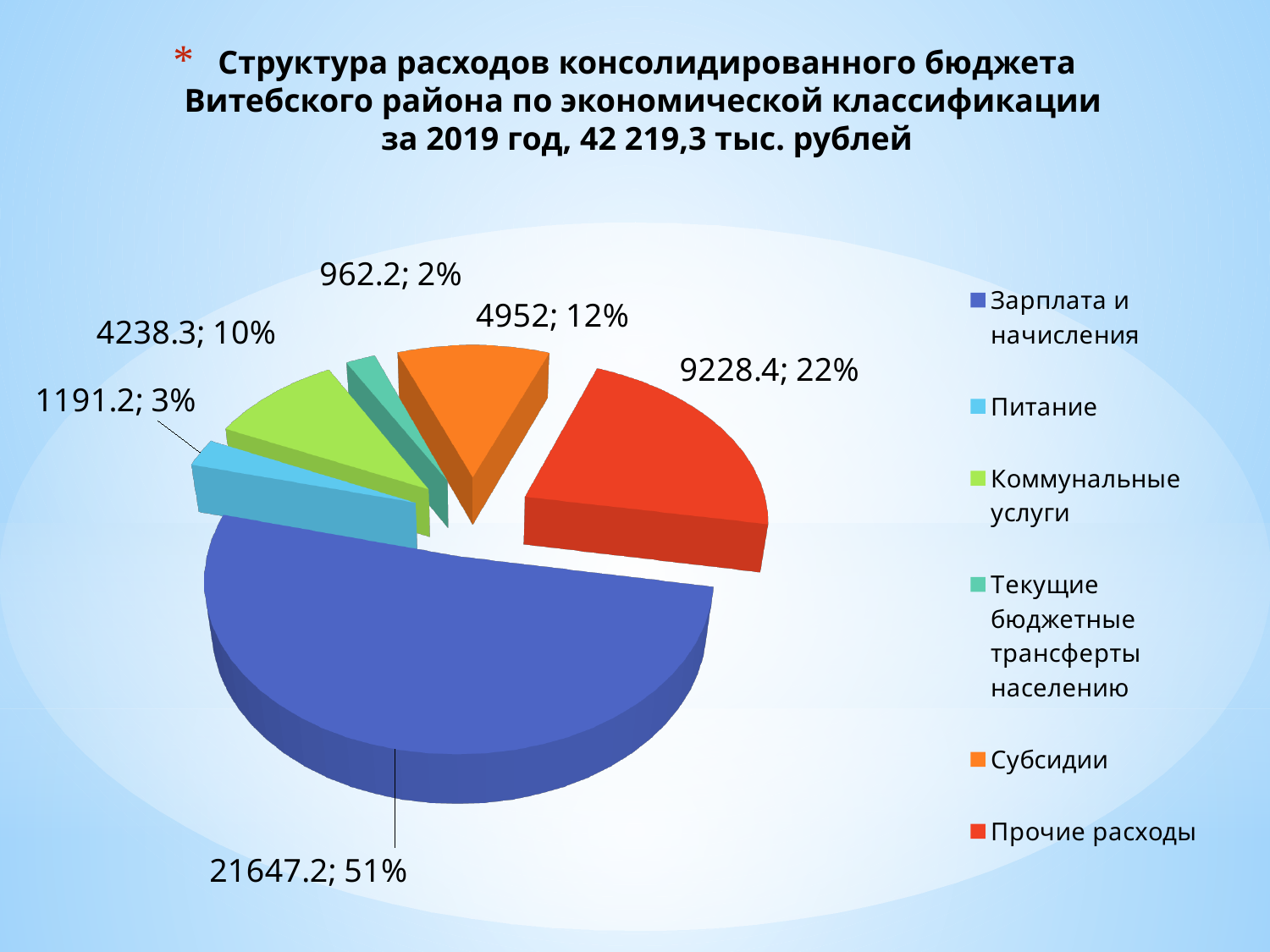
What percentage share does Субсидии have in the pie chart? 12% What value is shown for Зарплата и начисления? 21647.2 Which category has the largest slice in the pie chart? Зарплата и начисления Which is larger, the value for Питание or the value for Коммунальные услуги? Коммунальные услуги Which category has the smallest slice in the pie chart? Текущие бюджетные трансферты населению What kind of chart is shown on the slide? pie chart What is the difference between the values for Прочие расходы and Субсидии? 4276.4 What value is shown for Коммунальные услуги? 4238.3 What colour is the slice for Прочие расходы? red What value is shown for Прочие расходы? 9228.4 What percentage share does Зарплата и начисления have in the pie chart? 51% How many categories does the legend of the pie chart list? 6